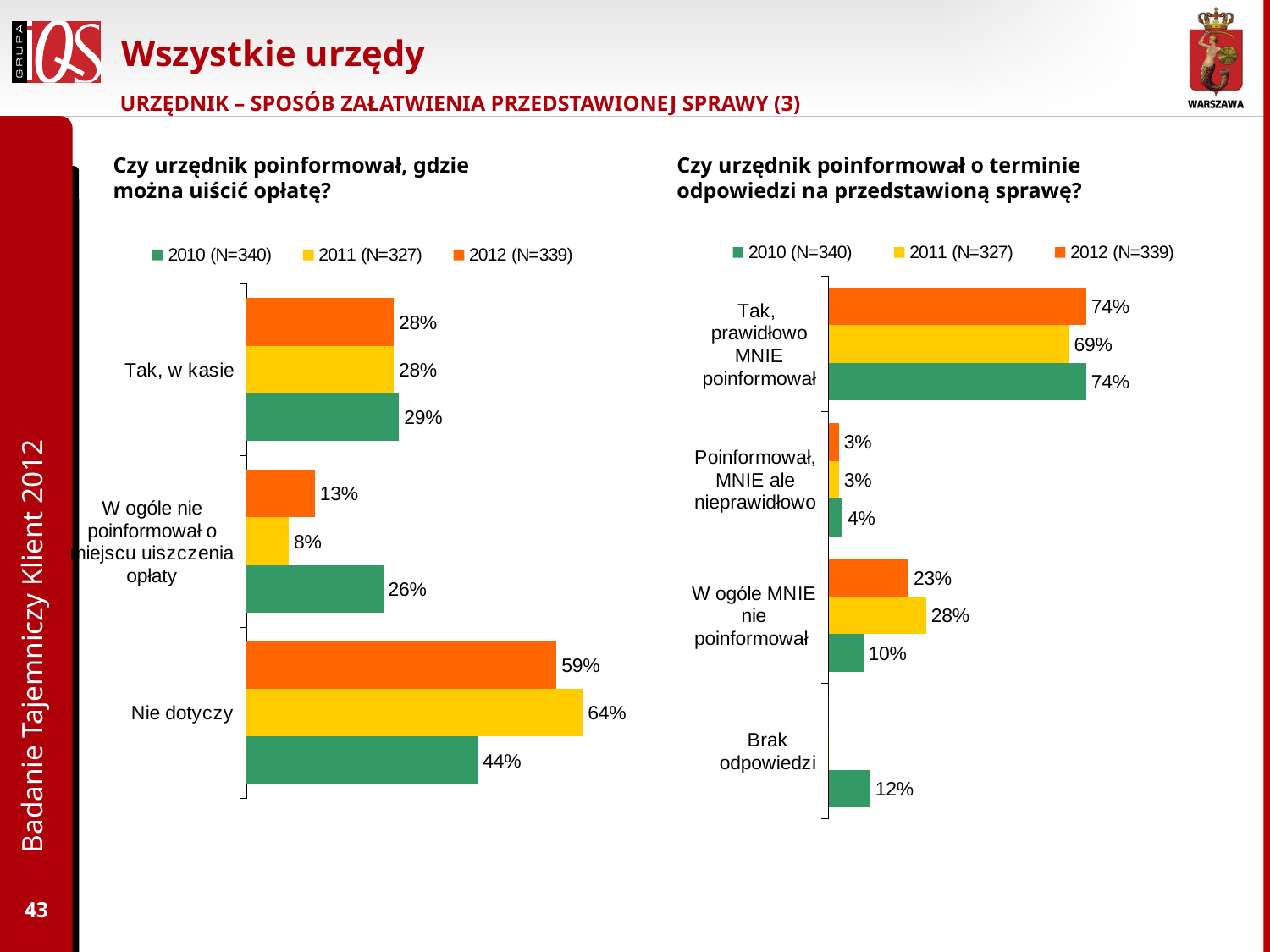
In the left chart (Czy urzędnik poinformował, gdzie można uiścić opłatę?), what is the value for 'Nie dotyczy' in 2011 (N=327)? 64% In the right chart (Czy urzędnik poinformował o terminie odpowiedzi na przedstawioną sprawę?), what is the difference between the 2012 and 2011 values for 'Tak, prawidłowo MNIE poinformował'? 5 percentage points In the right chart (Czy urzędnik poinformował o terminie odpowiedzi na przedstawioną sprawę?), what is the value for 'Brak odpowiedzi' in 2010 (N=340)? 12% What type of chart is the left chart (Czy urzędnik poinformował, gdzie można uiścić opłatę?)? Bar chart In the right chart (Czy urzędnik poinformował o terminie odpowiedzi na przedstawioną sprawę?), what is the value for 'W ogóle MNIE nie poinformował' in 2010 (N=340)? 10% In the left chart (Czy urzędnik poinformował, gdzie można uiścić opłatę?), how many series does the legend list? 3 In the right chart (Czy urzędnik poinformował o terminie odpowiedzi na przedstawioną sprawę?), what is the value for 'Tak, prawidłowo MNIE poinformował' in 2011 (N=327)? 69% In the left chart (Czy urzędnik poinformował, gdzie można uiścić opłatę?), what is the value for 'Tak, w kasie' in 2010 (N=340)? 29% In the left chart (Czy urzędnik poinformował, gdzie można uiścić opłatę?), which category has the highest value for 2012 (N=339)? Nie dotyczy In the right chart (Czy urzędnik poinformował o terminie odpowiedzi na przedstawioną sprawę?), how many categories are shown on the axis? 4 In the right chart (Czy urzędnik poinformował o terminie odpowiedzi na przedstawioną sprawę?), which is larger for 'W ogóle MNIE nie poinformował': the 2011 value or the 2012 value? 2011 (28%) In the left chart (Czy urzędnik poinformował, gdzie można uiścić opłatę?), what is the difference between the 2010 and 2011 values for 'W ogóle nie poinformował o miejscu uiszczenia opłaty'? 18 percentage points